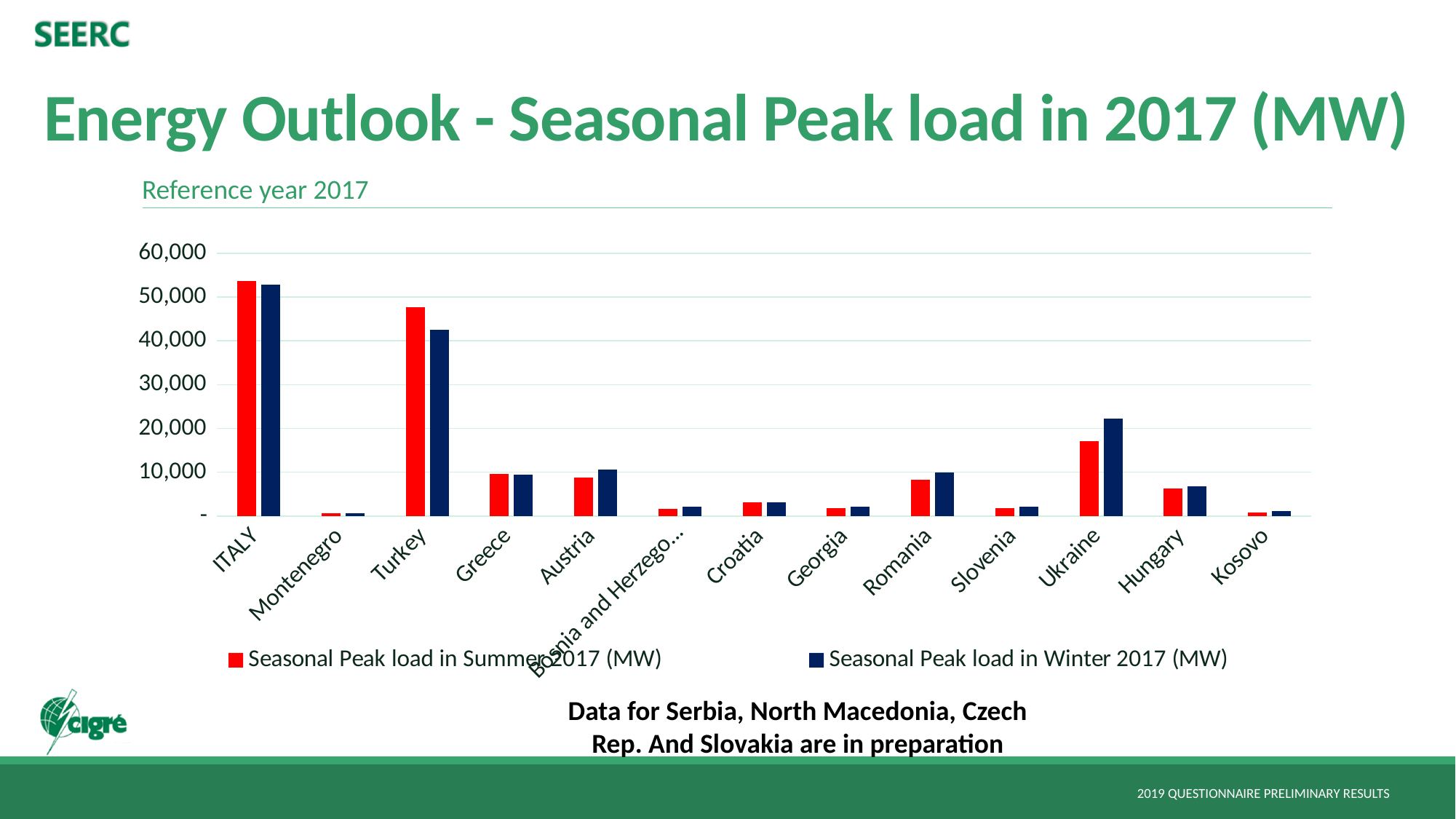
Is the Seasonal Peak load in Summer 2017 (MW) for Turkey greater or less than 40,000? greater What kind of chart is shown on the slide? bar chart Which country has the highest Seasonal Peak load in Winter 2017 (MW)? ITALY Is the Seasonal Peak load in Winter 2017 (MW) for Ukraine greater or less than 10,000? greater Which country has the highest Seasonal Peak load in Summer 2017 (MW)? ITALY Is the Seasonal Peak load in Summer 2017 (MW) for Ukraine greater or less than 20,000? less For Ukraine, which is larger: the Seasonal Peak load in Summer 2017 (MW) or the Seasonal Peak load in Winter 2017 (MW)? Seasonal Peak load in Winter 2017 (MW) How many countries are shown on the x axis of the chart? 13 How many series does the chart's legend list? 2 For Turkey, which is larger: the Seasonal Peak load in Summer 2017 (MW) or the Seasonal Peak load in Winter 2017 (MW)? Seasonal Peak load in Summer 2017 (MW) Which colour represents the Seasonal Peak load in Summer 2017 (MW) series in the chart? red